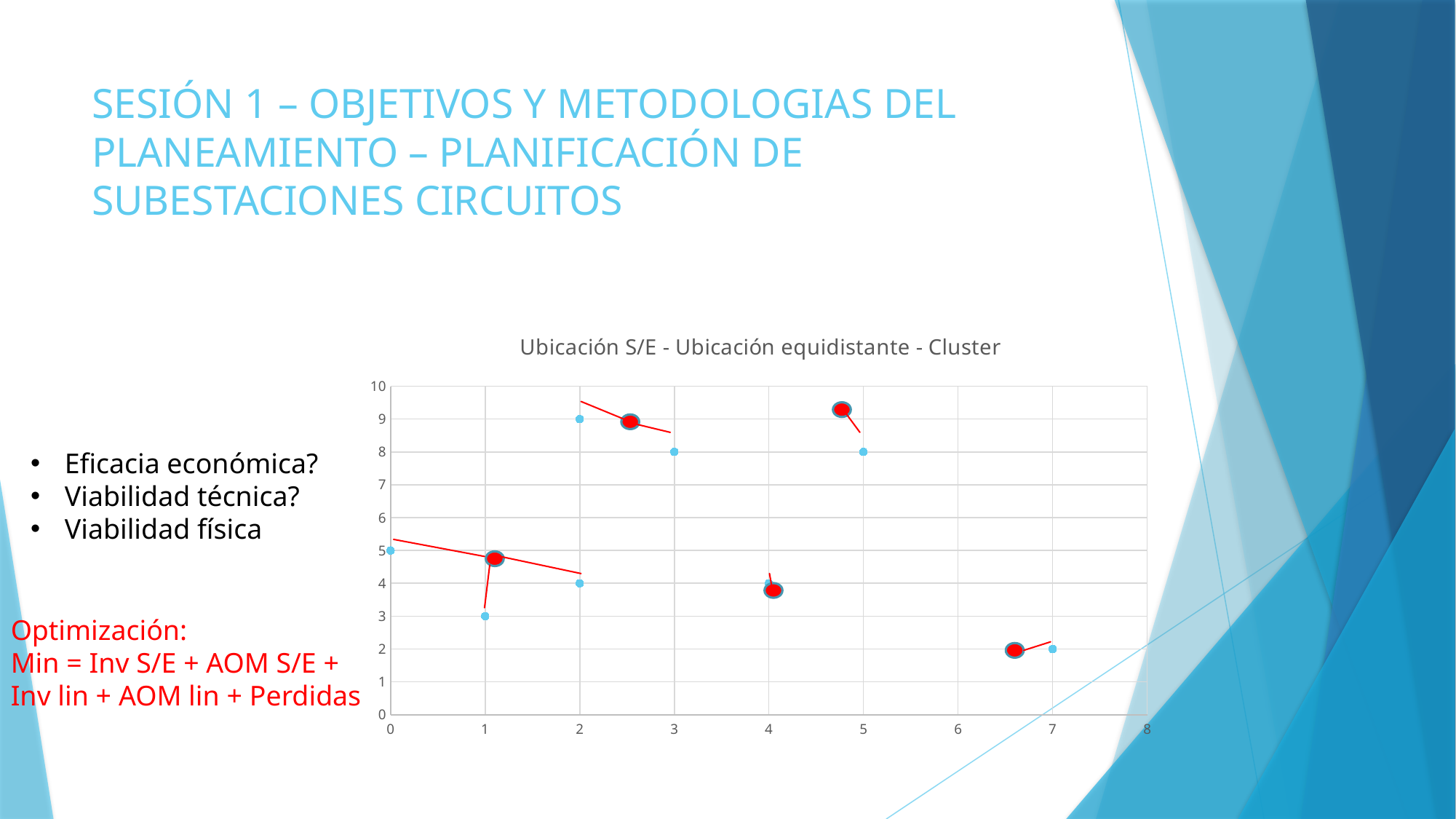
What is the y value of the small blue point located at x = 0? 5 What is the maximum value shown on the vertical axis of the chart? 10 Which small blue point has the highest y value? the point at x = 2, y = 9 Which small blue point has the lowest y value? the point at x = 7, y = 2 What is the y value of the small blue point located at x = 3? 8 Is the y value of the large red point near x = 6.6 greater or less than 3? less What kind of chart is shown on the slide? scatter chart How many large red points are plotted on the chart? 5 Is the y value of the large red point near x = 4.8 greater or less than 9? greater What is the title of the chart? Ubicación S/E - Ubicación equidistante - Cluster What is the y value of the small blue point located at x = 7? 2